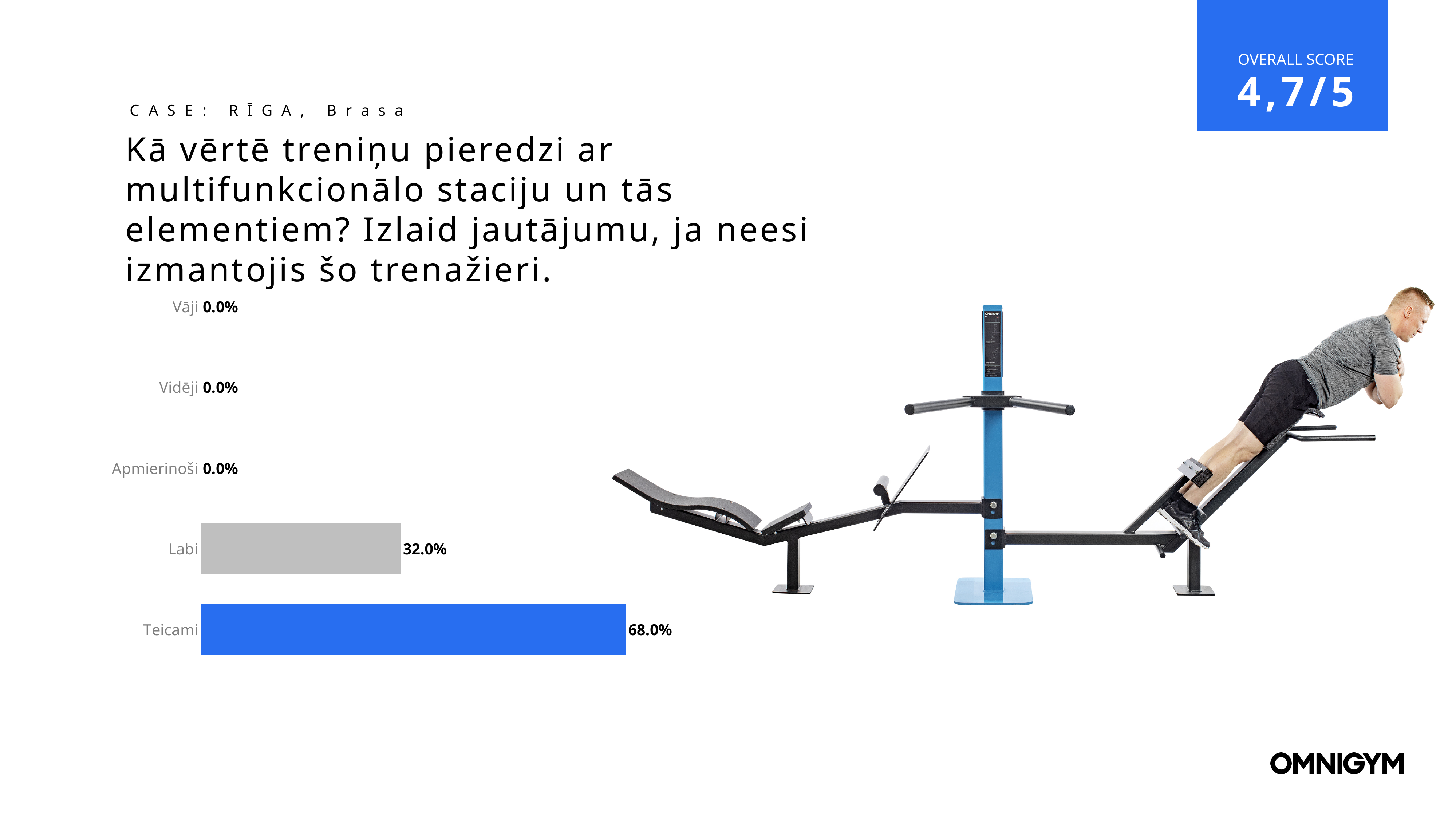
What is the value for Vāji? 0.0% What colour is the bar for Teicami? Blue What is the total of the values for Labi and Teicami? 100.0% What is the value for Apmierinoši? 0.0% How many categories are shown in the chart? 5 Which is larger, the value for Labi or the value for Teicami? Teicami What is the value for Teicami? 68.0% How many categories have a value of 0.0%? 3 Which category has the highest value? Teicami What is the difference between the values for Teicami and Labi? 36.0% What kind of chart is shown on the slide? Bar chart What is the value for Labi? 32.0%